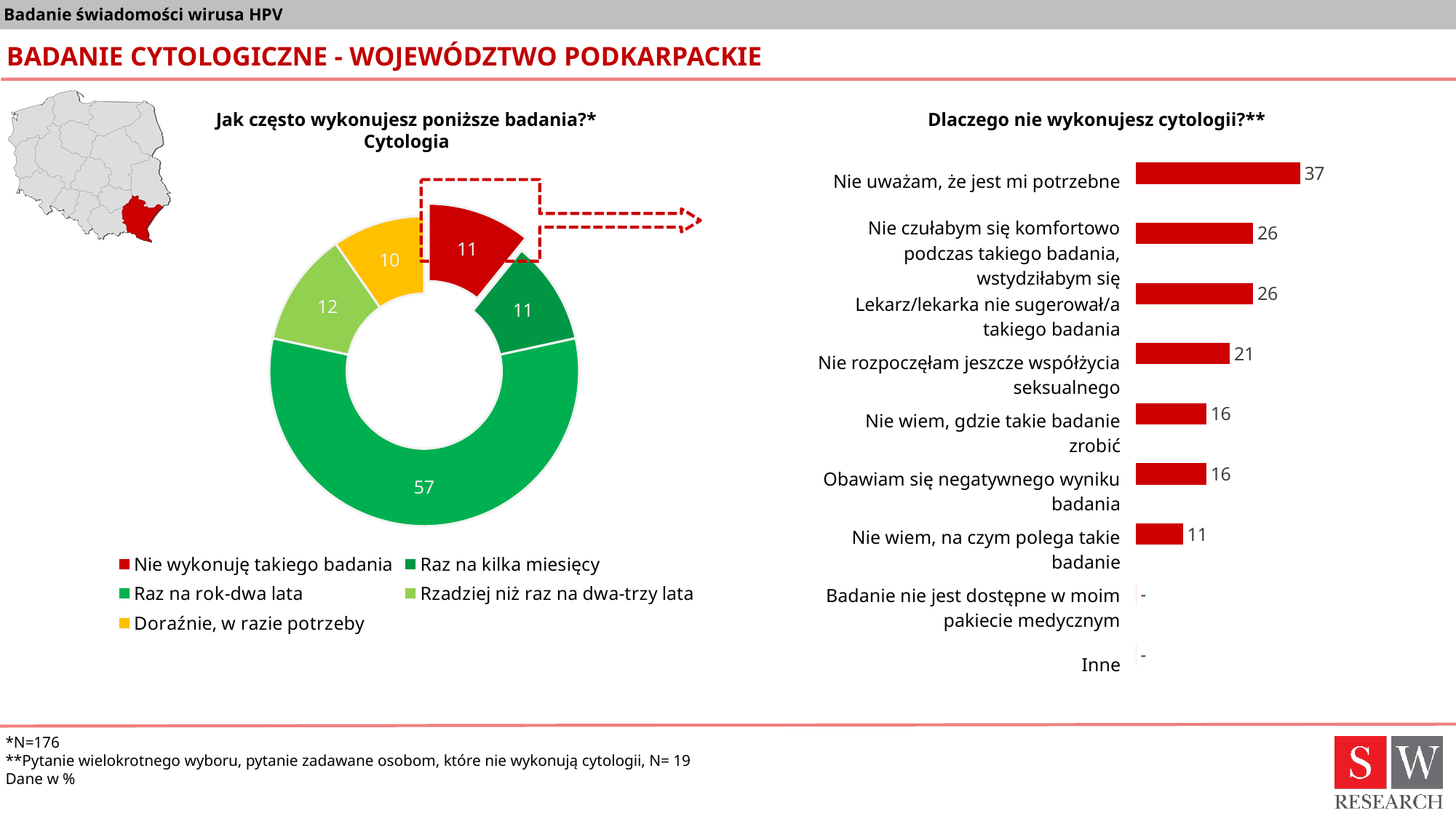
In the bar chart 'Dlaczego nie wykonujesz cytologii?', what is the value for 'Nie rozpoczęłam jeszcze współżycia seksualnego'? 21 In the bar chart 'Dlaczego nie wykonujesz cytologii?', which is larger: 'Nie wiem, gdzie takie badanie zrobić' or 'Nie wiem, na czym polega takie badanie'? Nie wiem, gdzie takie badanie zrobić In the donut chart 'Jak często wykonujesz poniższe badania? Cytologia', which category has the smallest value? Doraźnie, w razie potrzeby In the bar chart 'Dlaczego nie wykonujesz cytologii?', which reason has the highest value? Nie uważam, że jest mi potrzebne In the donut chart 'Jak często wykonujesz poniższe badania? Cytologia', what is the difference between 'Raz na rok-dwa lata' and 'Rzadziej niż raz na dwa-trzy lata'? 45 What type of chart is 'Dlaczego nie wykonujesz cytologii?'? Bar chart In the donut chart 'Jak często wykonujesz poniższe badania? Cytologia', which category has the largest share? Raz na rok-dwa lata In the donut chart 'Jak często wykonujesz poniższe badania? Cytologia', what is the value for 'Doraźnie, w razie potrzeby'? 10 In the bar chart 'Dlaczego nie wykonujesz cytologii?', what is the difference between 'Nie uważam, że jest mi potrzebne' and 'Lekarz/lekarka nie sugerował/a takiego badania'? 11 In the bar chart 'Dlaczego nie wykonujesz cytologii?', what is the value for 'Nie uważam, że jest mi potrzebne'? 37 In the donut chart 'Jak często wykonujesz poniższe badania? Cytologia', what is the value for 'Raz na rok-dwa lata'? 57 In the donut chart 'Jak często wykonujesz poniższe badania? Cytologia', how many categories does the legend list? 5